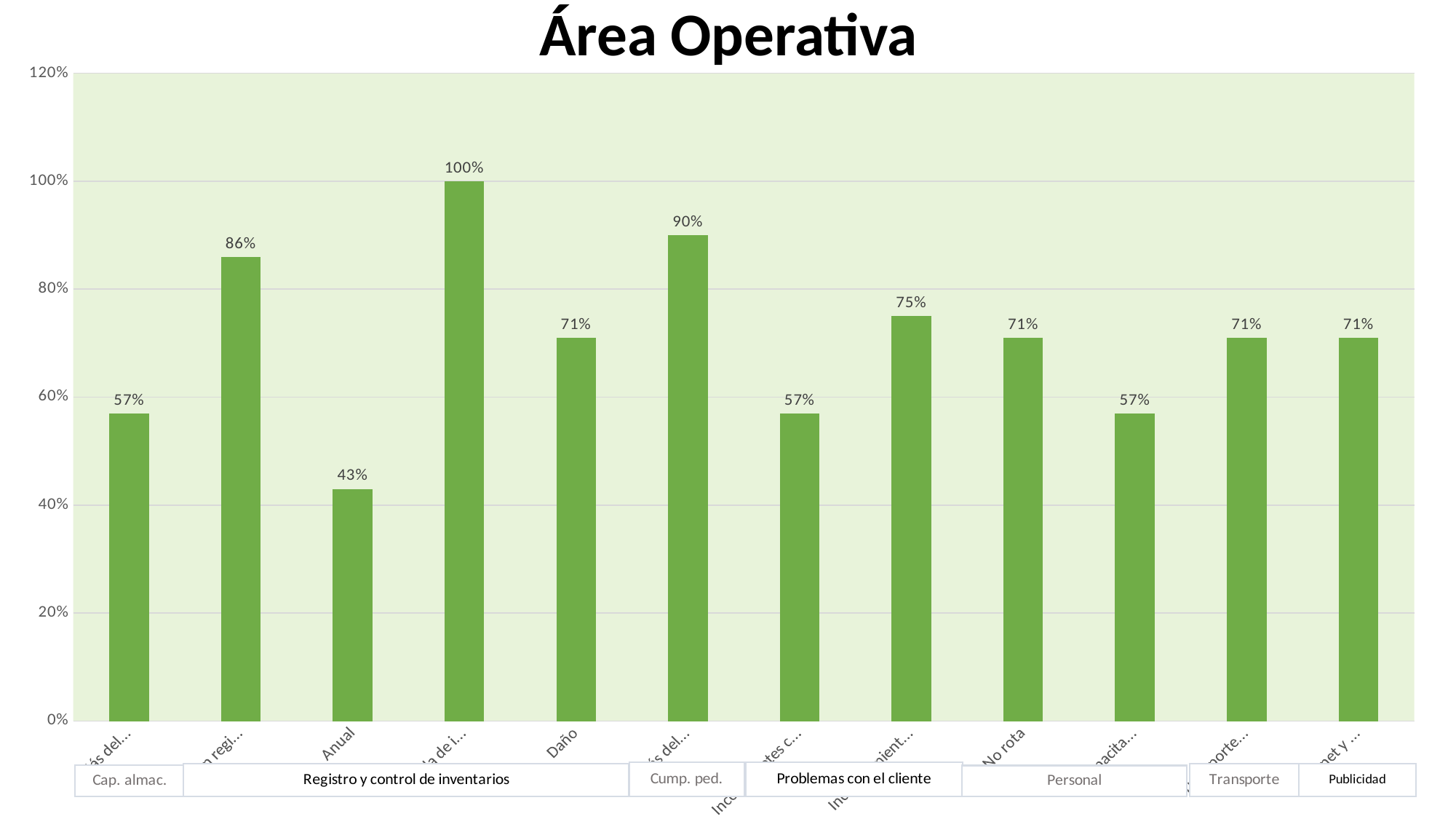
What kind of chart is shown on the slide? bar chart What is the value of the single bar in the "Cump. ped." group? 90% What is the value of the bar labelled "No rota"? 71% What is the difference between the values for "Daño" and "Anual"? 28 percentage points What is the value of the bar labelled "Daño"? 71% Which bar has the lowest value in the chart? Anual What is the value of the bar labelled "Anual"? 43% What is the highest value shown in the chart? 100% How many bars are plotted in the chart? 12 What is the title of the chart? Área Operativa What is the value of the single bar in the "Cap. almac." group? 57% Which is larger, the value for "Anual" or the value for "Daño"? Daño